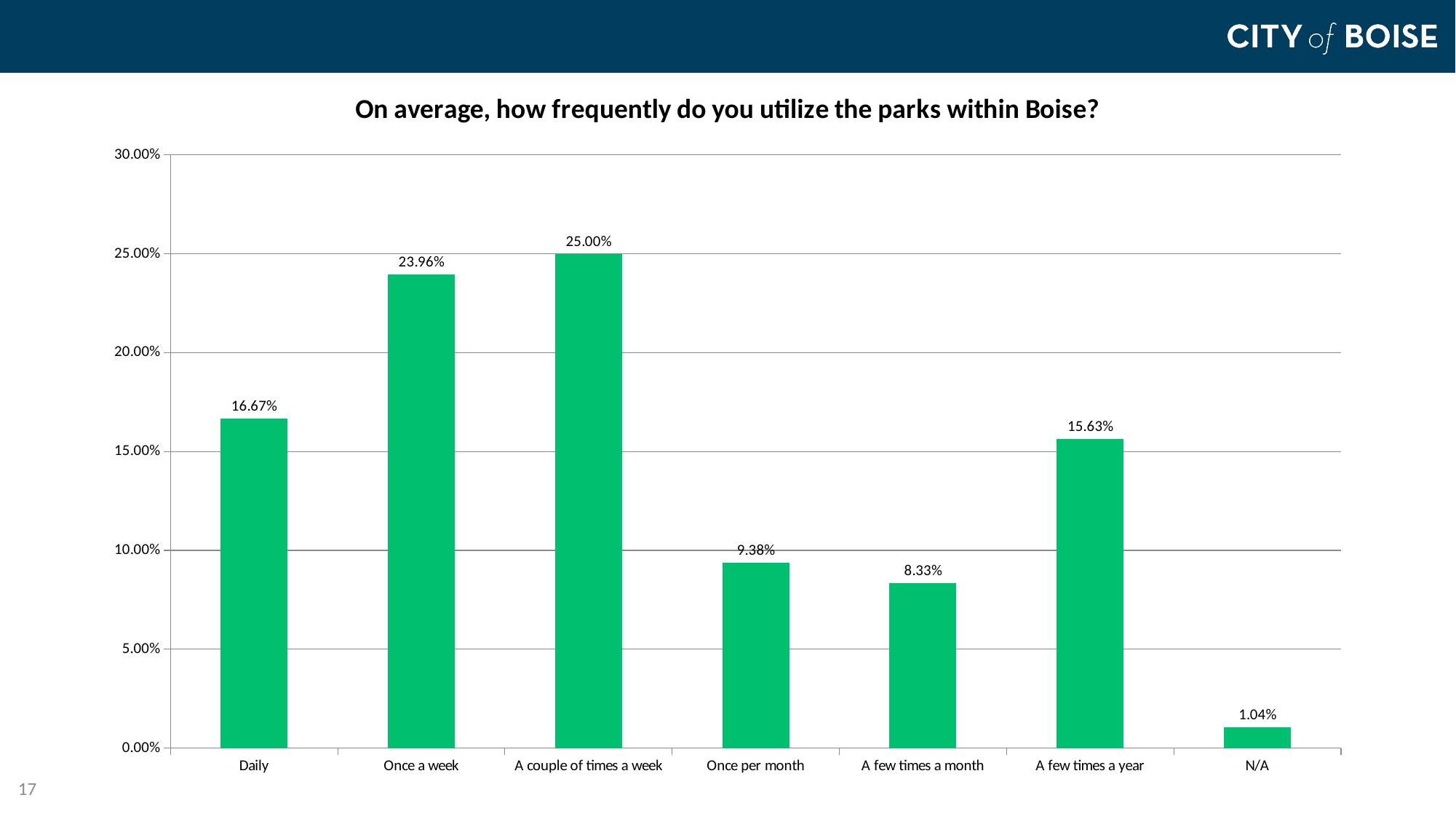
Is the value for 'Once a week' greater or less than 20.00%? greater What kind of chart is shown on the slide? Bar chart Which is larger, 'Once per month' or 'A few times a month'? Once per month What is the difference between 'Daily' and 'A few times a year'? 1.04% What is the value for 'Once per month'? 9.38% What is the value for 'A few times a year'? 15.63% How many categories are shown on the x axis? 7 Which category has the highest value? A couple of times a week What is the difference between 'A couple of times a week' and 'Once a week'? 1.04% Which category has the lowest value? N/A What percentage of respondents said they use Boise parks daily? 16.67% What is the title of the chart? On average, how frequently do you utilize the parks within Boise?